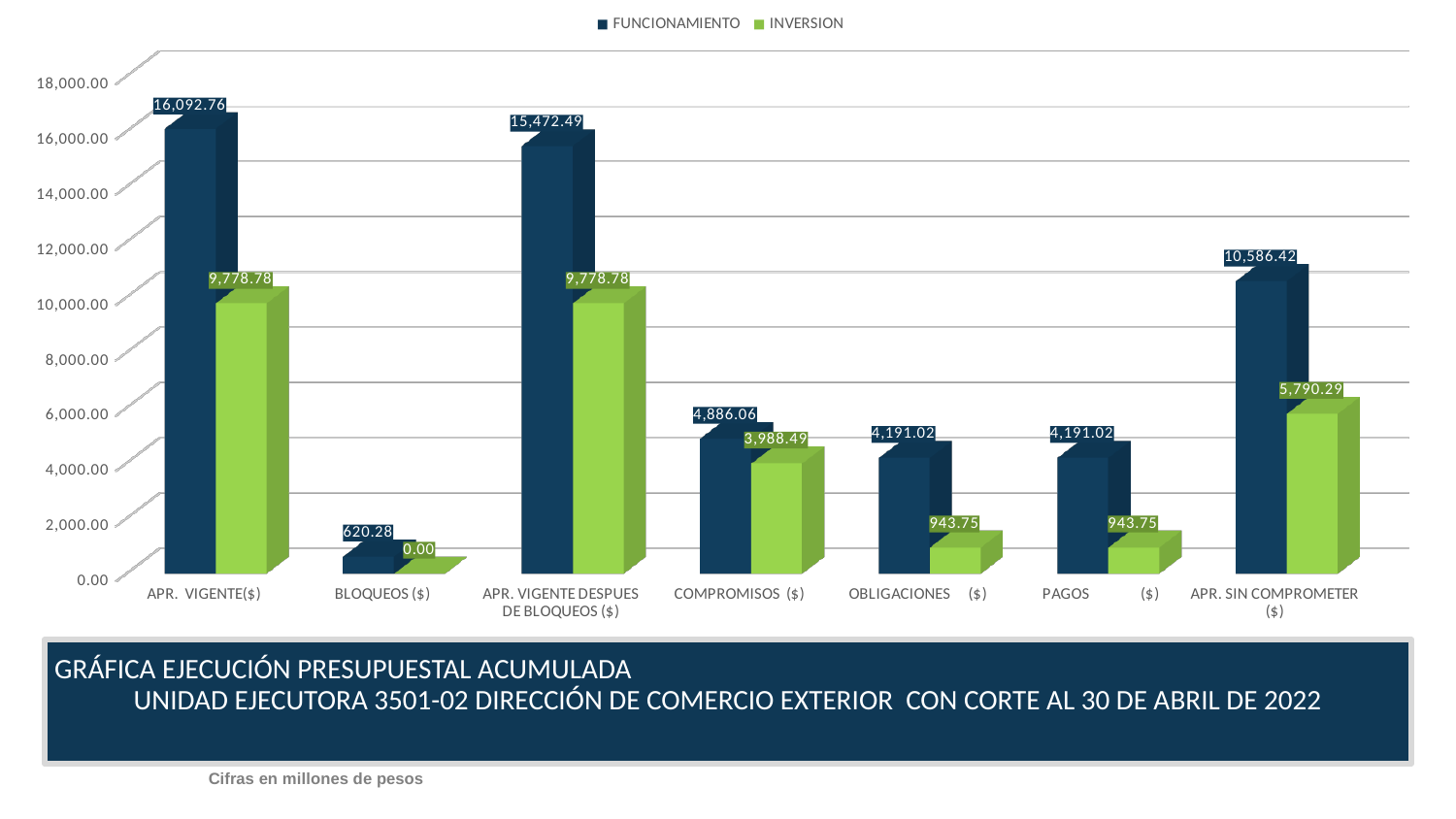
What is the difference between the FUNCIONAMIENTO and INVERSION values for COMPROMISOS ($)? 897.57 What is the FUNCIONAMIENTO value for APR. VIGENTE($)? 16,092.76 For PAGOS ($), which series has the larger value, FUNCIONAMIENTO or INVERSION? FUNCIONAMIENTO Which category has the lowest INVERSION value? BLOQUEOS ($) What is the INVERSION value for OBLIGACIONES ($)? 943.75 What is the difference between the FUNCIONAMIENTO and INVERSION values for APR. VIGENTE($)? 6,313.98 What is the INVERSION value for APR. SIN COMPROMETER ($)? 5,790.29 How many categories are shown on the x axis? 7 What kind of chart is shown on the slide? Bar chart Which category has the highest FUNCIONAMIENTO value? APR. VIGENTE($) How many series does the legend list? 2 What is the FUNCIONAMIENTO value for BLOQUEOS ($)? 620.28